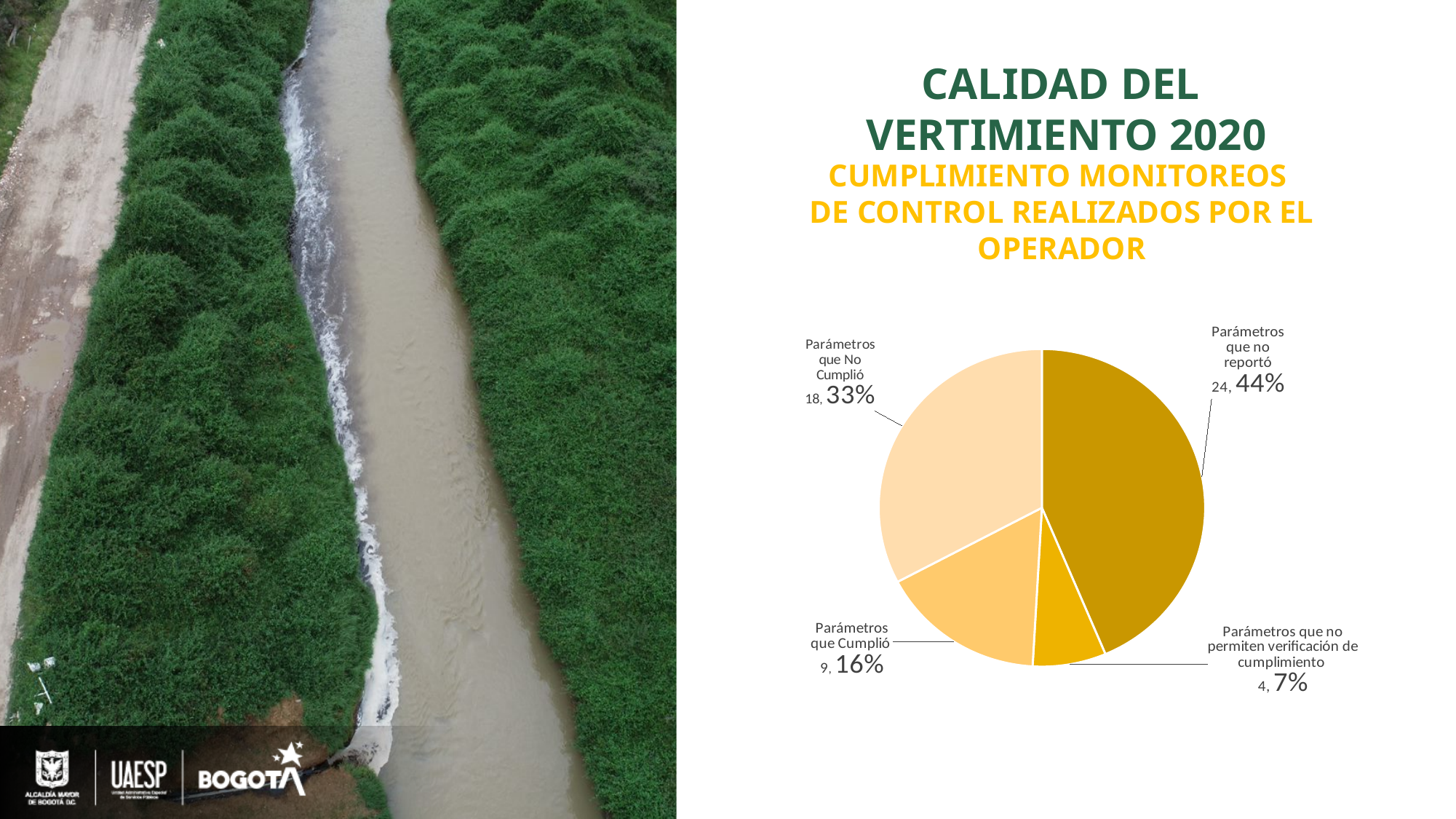
What is the total count across all four slices of the pie? 55 What is the difference in count between 'Parámetros que no reportó' and 'Parámetros que No Cumplió'? 6 What count is shown for 'Parámetros que No Cumplió'? 18 Which category has the largest slice of the pie? Parámetros que no reportó How many slices does the pie chart have? 4 Which category has the smallest slice of the pie? Parámetros que no permiten verificación de cumplimiento What kind of chart is shown on the slide? pie chart What is the main title shown above the chart on the slide? CALIDAD DEL VERTIMIENTO 2020 What percentage share is shown for 'Parámetros que no reportó'? 44% Which is larger: the count for 'Parámetros que Cumplió' or for 'Parámetros que No Cumplió'? Parámetros que No Cumplió What percentage share is shown for 'Parámetros que Cumplió'? 16% What count is shown for 'Parámetros que no permiten verificación de cumplimiento'? 4